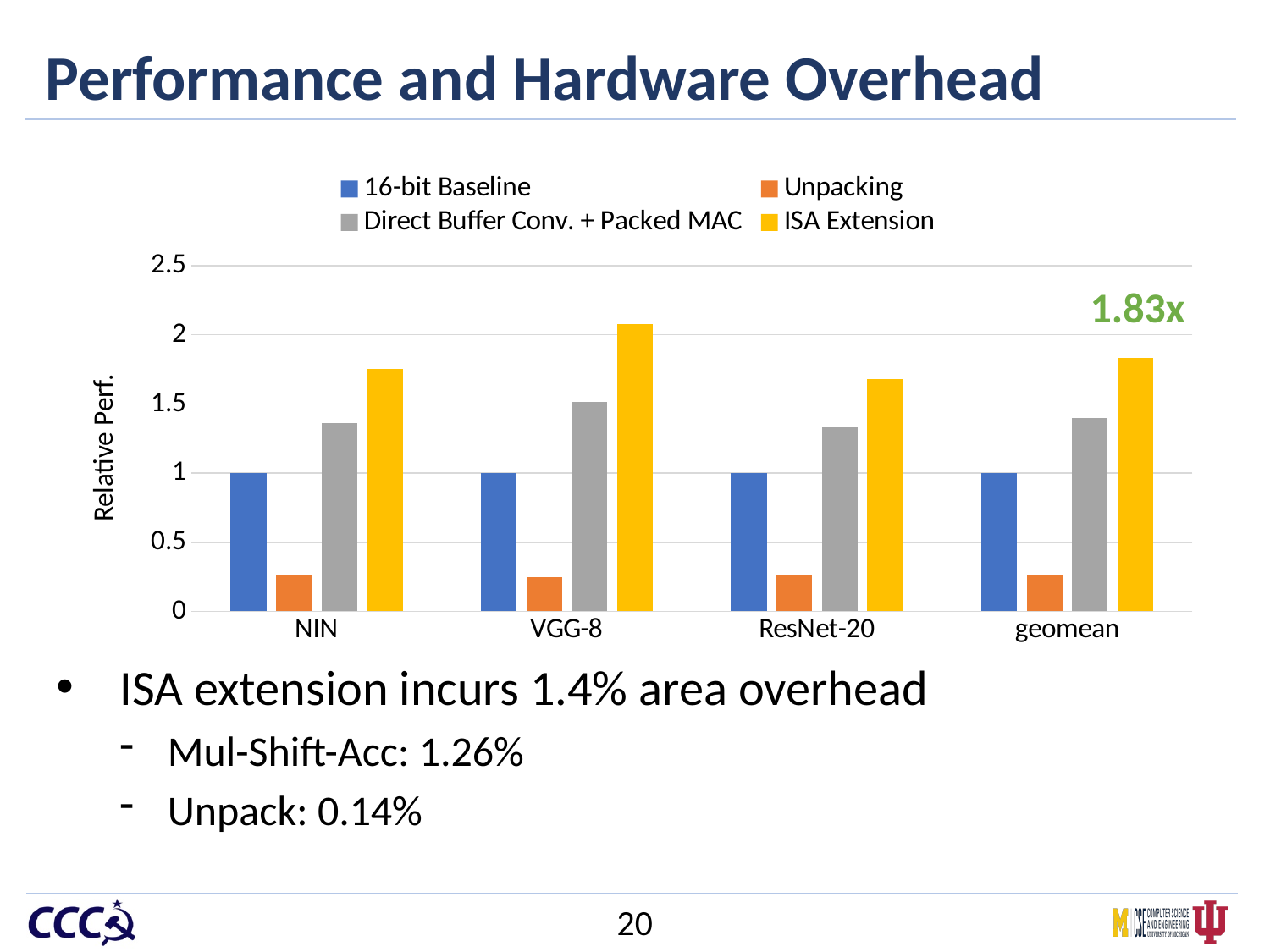
What is the label on the y axis of the chart? Relative Perf. Which category has the highest ISA Extension bar? VGG-8 What value is annotated for the ISA Extension bar in the geomean group? 1.83x What is the relative performance of the 16-bit Baseline for NIN? 1 What kind of chart is shown on the slide? bar chart Is the ISA Extension value for ResNet-20 greater or less than 1.5? greater How many categories are shown along the x axis of the chart? 4 Is the Unpacking value for NIN greater or less than 0.5? less Which series has the lowest bar in the NIN group? Unpacking Is the Direct Buffer Conv. + Packed MAC value for ResNet-20 greater or less than 1.5? less For NIN, which is larger: the ISA Extension bar or the Direct Buffer Conv. + Packed MAC bar? ISA Extension How many series does the chart's legend list? 4